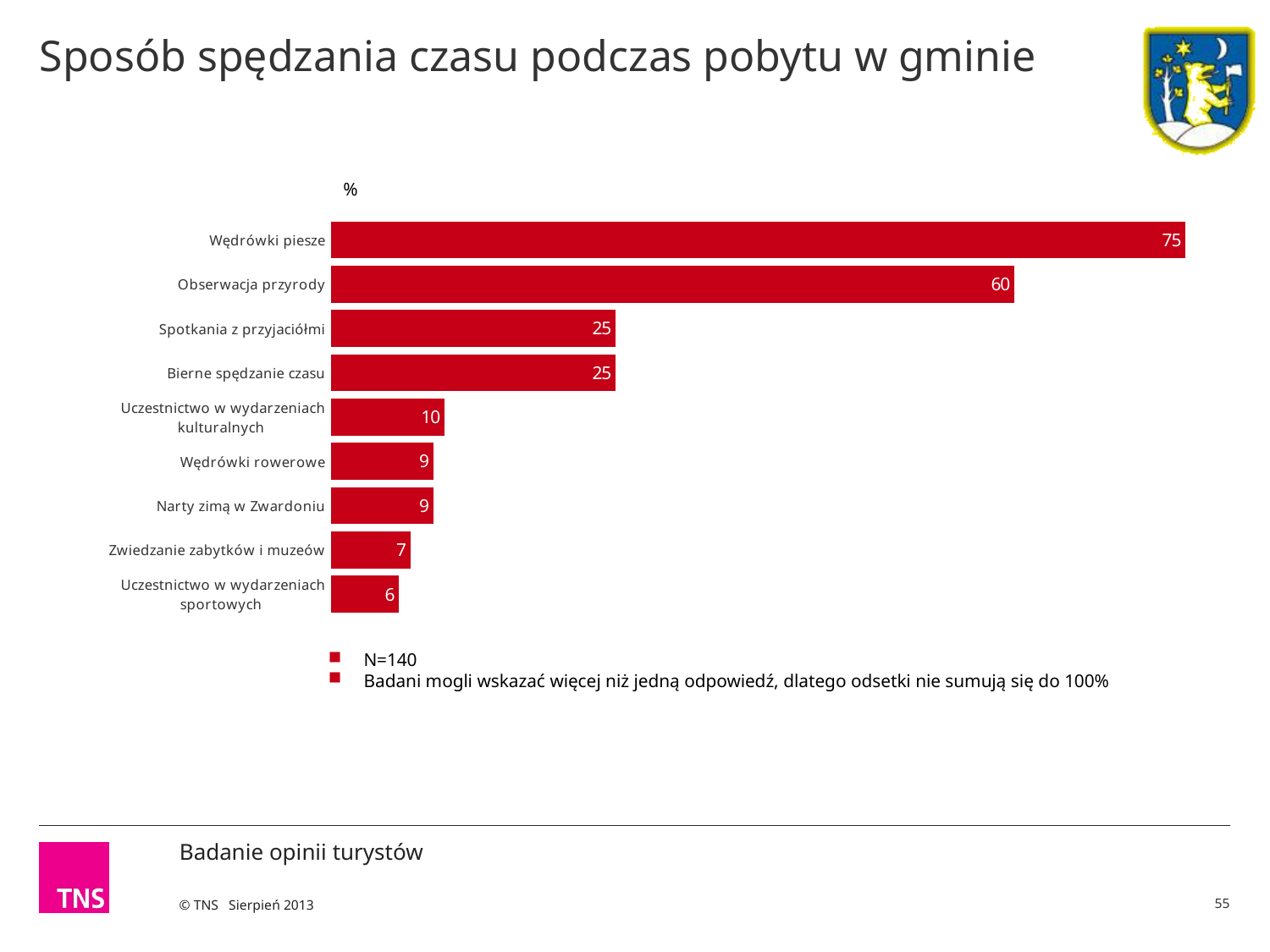
What kind of chart is shown on the slide? Bar chart What is the title of the slide? Sposób spędzania czasu podczas pobytu w gminie What is the value for Wędrówki piesze? 75 Which category has the highest value? Wędrówki piesze What is the value for Obserwacja przyrody? 60 What is the difference between the values for Wędrówki piesze and Obserwacja przyrody? 15 Which is larger, the value for Bierne spędzanie czasu or the value for Narty zimą w Zwardoniu? Bierne spędzanie czasu What is the value for Zwiedzanie zabytków i muzeów? 7 What is the value for Uczestnictwo w wydarzeniach kulturalnych? 10 Which category has the lowest value? Uczestnictwo w wydarzeniach sportowych How many categories are shown in the chart? 9 What is the difference between the values for Spotkania z przyjaciółmi and Wędrówki rowerowe? 16